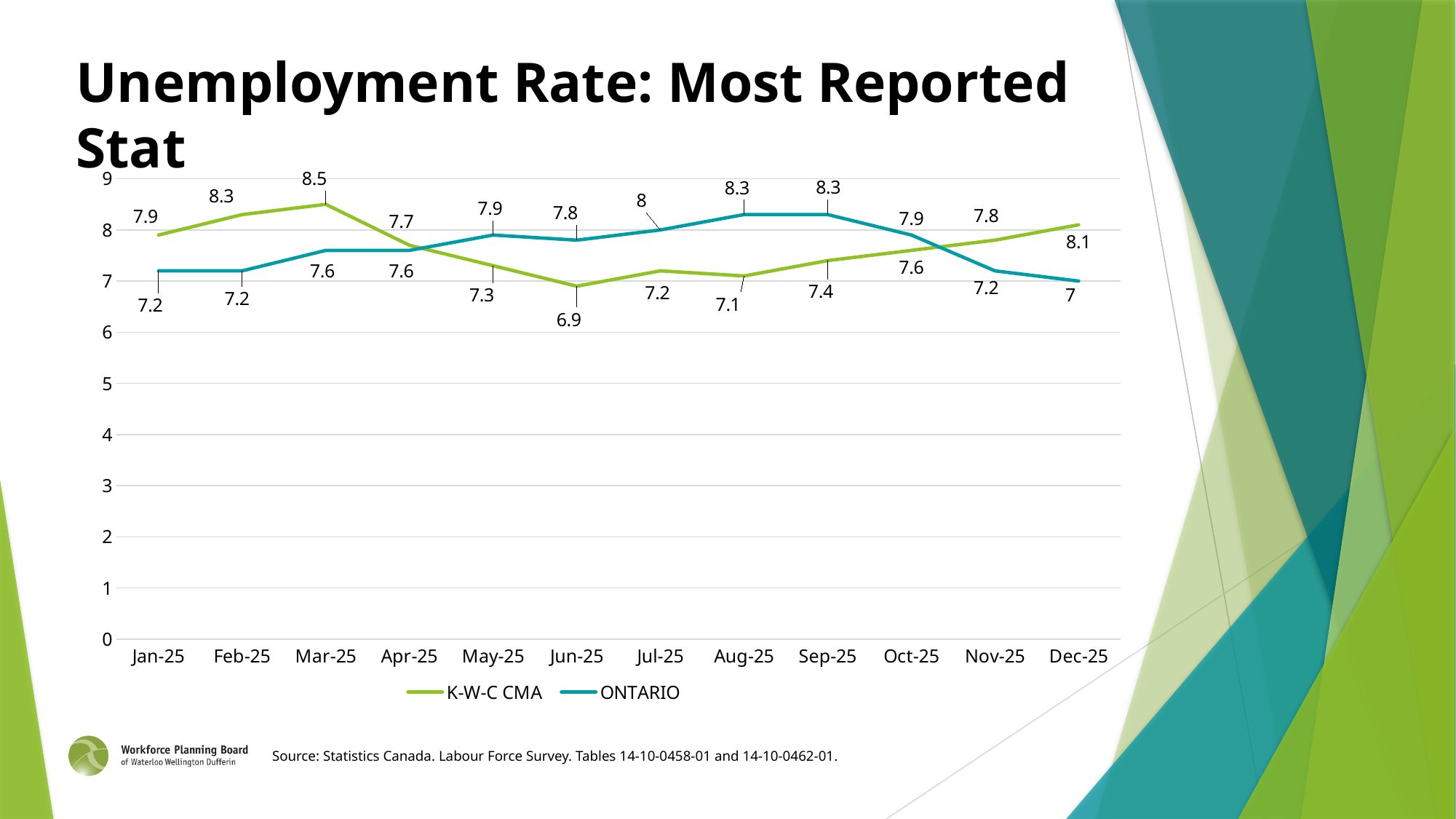
What is the ONTARIO unemployment rate for Dec-25? 7 In which month is the K-W-C CMA rate lowest? Jun-25 Does the K-W-C CMA rate rise or fall from Jun-25 to Dec-25? rise In Aug-25, which series has the higher unemployment rate, K-W-C CMA or ONTARIO? ONTARIO What is the K-W-C CMA unemployment rate for Mar-25? 8.5 What kind of chart is shown on the slide? line chart What is the difference between the K-W-C CMA and ONTARIO rates in Mar-25? 0.9 What is the ONTARIO unemployment rate for Jul-25? 8 In which month is the K-W-C CMA rate highest? Mar-25 In which month is the ONTARIO rate lowest? Dec-25 How many series does the legend list? 2 How many months are plotted along the x axis? 12